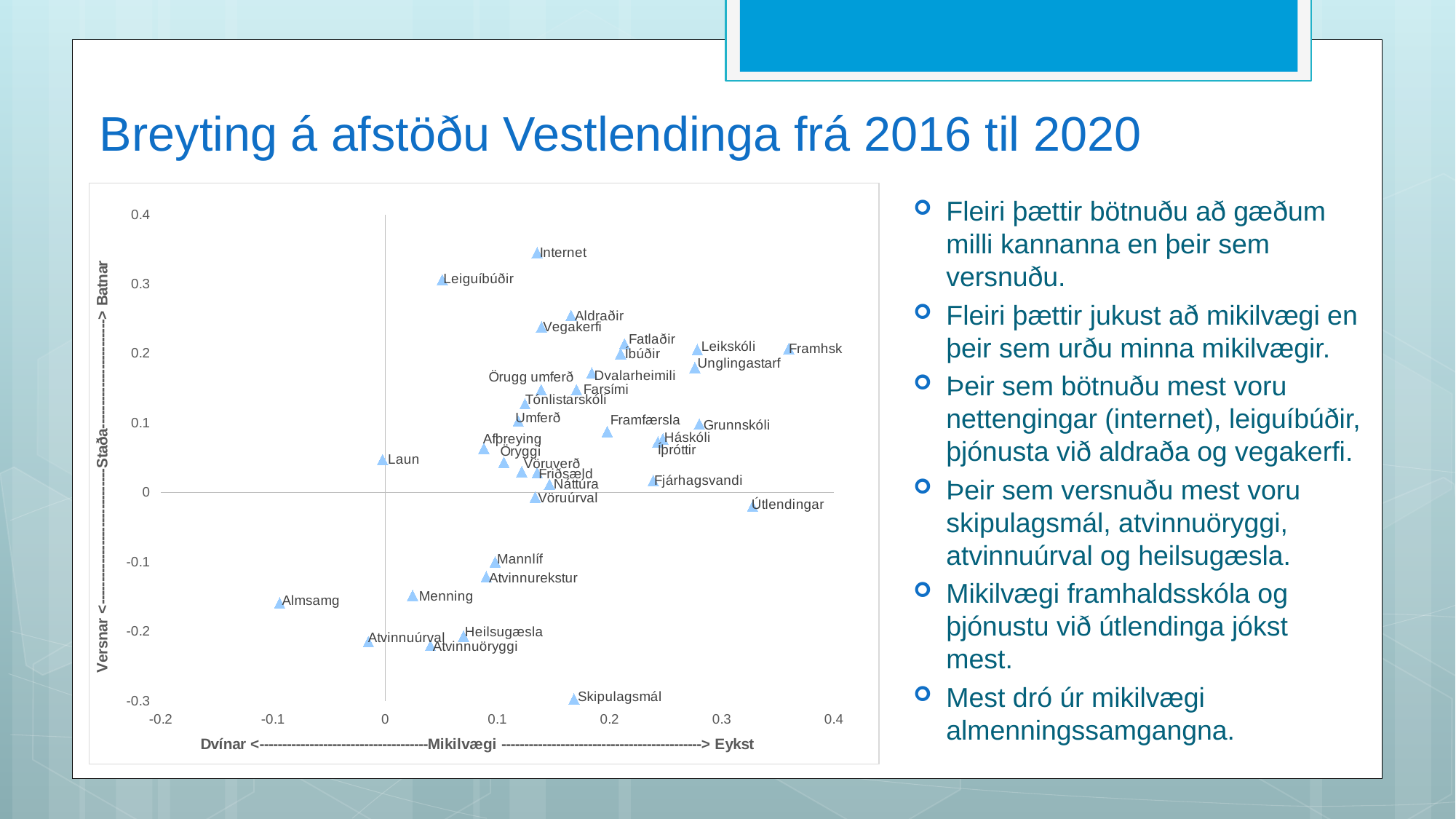
What is the label of the horizontal axis of the chart? Dvínar <---Mikilvægi ---> Eykst Which labelled point has the lowest value on the vertical (Staða) axis? Skipulagsmál Is the vertical-axis value for Internet greater or less than 0.3? greater Which labelled point lies furthest to the right on the horizontal (Mikilvægi) axis? Framhsk Is the horizontal-axis value for Almsamg greater or less than 0? less Which labelled point has the highest value on the vertical (Staða) axis? Internet Which point is further right on the horizontal axis, Framhsk or Almsamg? Framhsk Which labelled point lies furthest to the left on the horizontal (Mikilvægi) axis? Almsamg Which point is higher on the vertical axis, Internet or Skipulagsmál? Internet Is the vertical-axis value for Mannlíf greater or less than 0? less What kind of chart is shown on the slide? Scatter chart